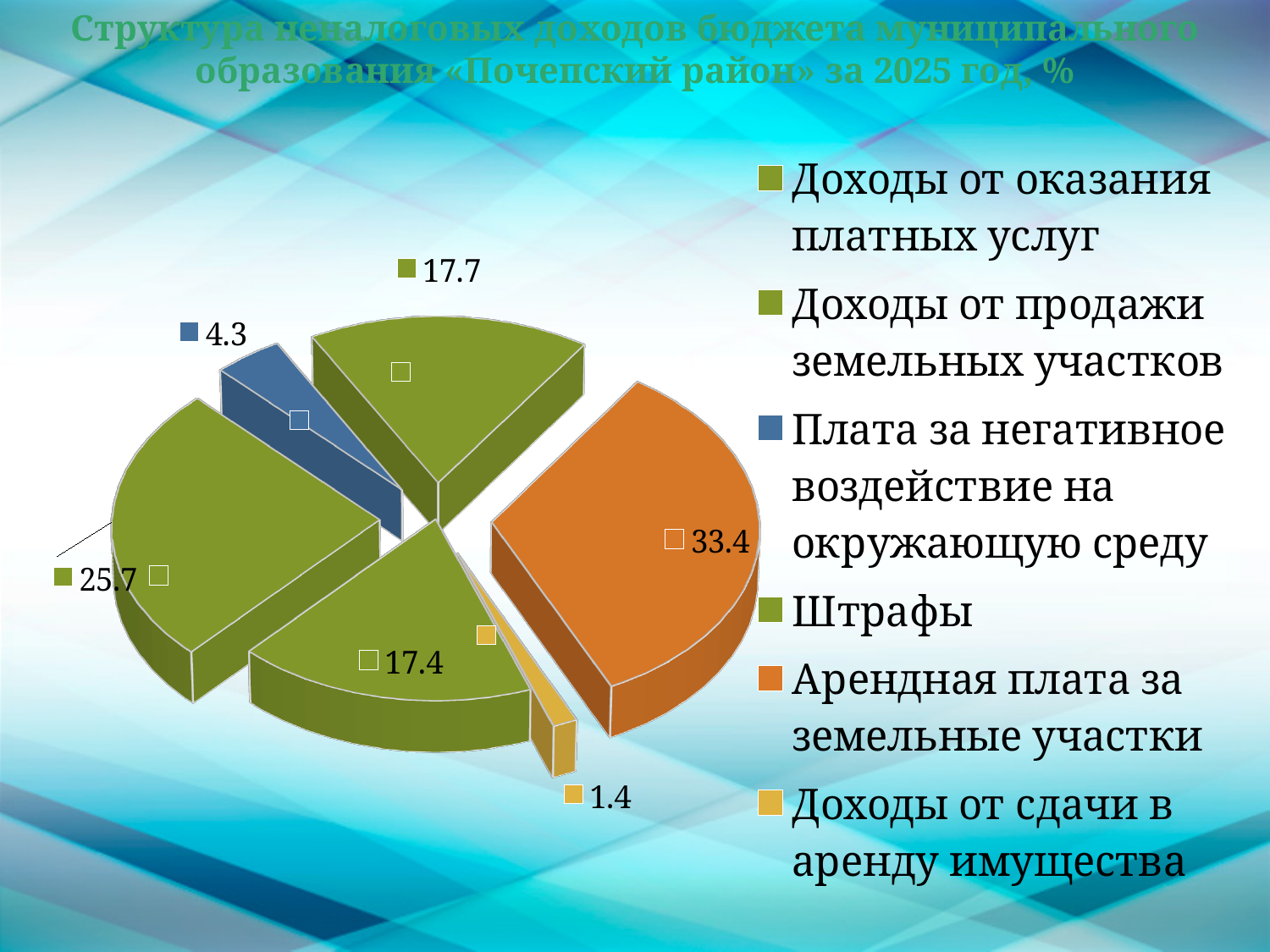
What is the value shown for Доходы от сдачи в аренду имущества? 1.4 What is the value shown for Плата за негативное воздействие на окружающую среду? 4.3 What kind of chart is shown on the slide? pie chart Which category has the largest slice in the pie chart? Арендная плата за земельные участки What is the difference between the values for Арендная плата за земельные участки and Плата за негативное воздействие на окружающую среду? 29.1 What colour is the slice for Арендная плата за земельные участки? orange What is the largest value labelled on the pie chart? 33.4 Which is larger: the slice for Арендная плата за земельные участки or the slice for Плата за негативное воздействие на окружающую среду? Арендная плата за земельные участки How many slices does the pie chart have? 6 Which category has the smallest slice in the pie chart? Доходы от сдачи в аренду имущества How many entries does the legend of the pie chart list? 6 What is the value shown for Арендная плата за земельные участки? 33.4